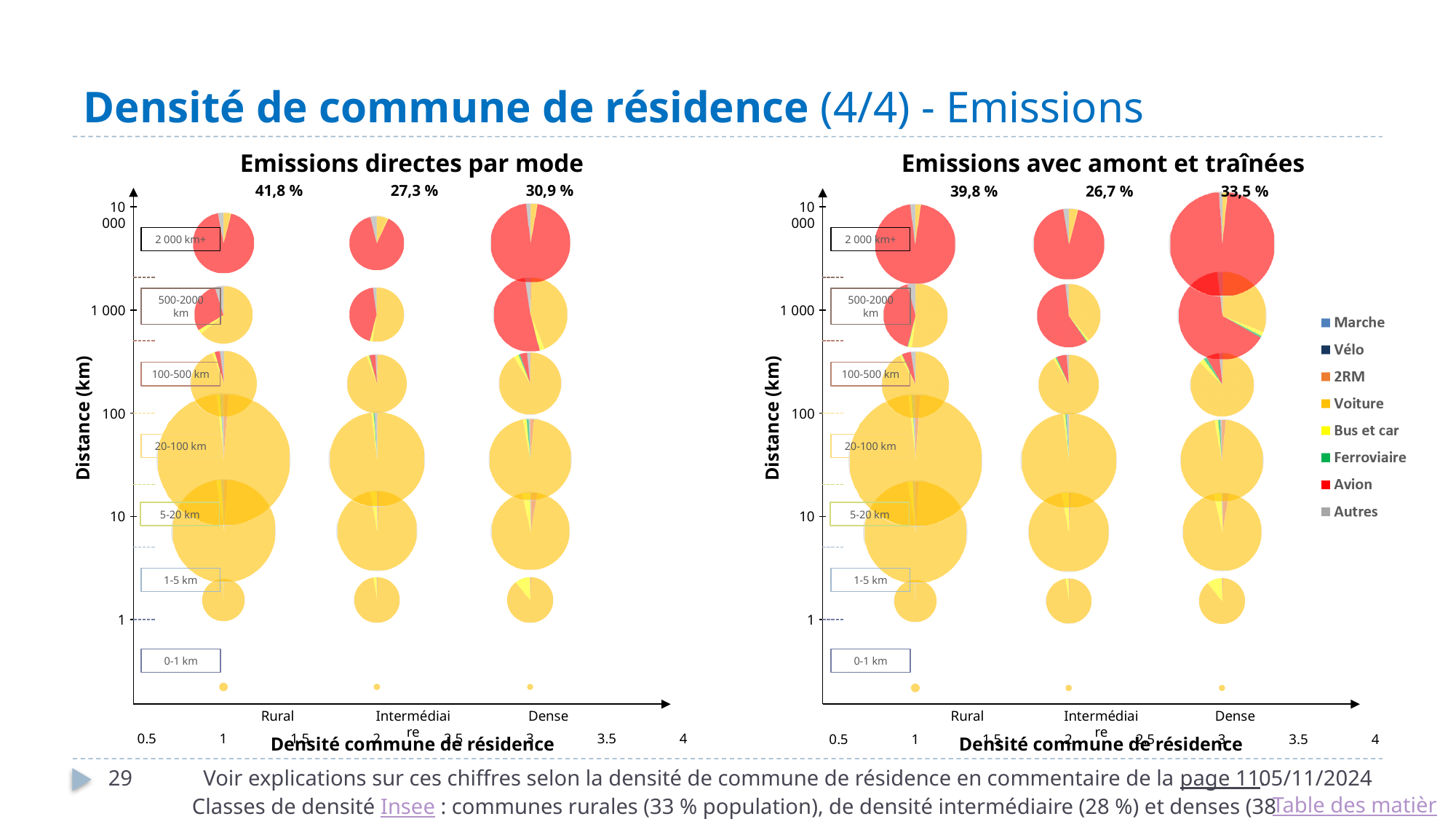
How many density categories are labelled along the x axis of each chart? 3 In the 'Emissions avec amont et traînées' chart, what percentage is printed above the Intermédiaire column? 26,7 % How many series does the legend on the right of the slide list? 8 In the 'Emissions directes par mode' chart, what is the difference between the Rural and Intermédiaire percentages? 14,5 % In the 'Emissions directes par mode' chart, which density category has the highest percentage printed above it? Rural Is the Dense percentage larger in the 'Emissions directes par mode' chart or in the 'Emissions avec amont et traînées' chart? Emissions avec amont et traînées In the 'Emissions avec amont et traînées' chart, what is the difference between the Dense and Intermédiaire percentages? 6,8 % In the 'Emissions directes par mode' chart, what percentage is printed above the Rural column? 41,8 % In the legend, which mode is shown in red? Avion In the 'Emissions avec amont et traînées' chart, which density category has the lowest percentage printed above it? Intermédiaire In the 'Emissions avec amont et traînées' chart, what percentage is printed above the Dense column? 33,5 % In the 'Emissions directes par mode' chart, what percentage is printed above the Dense column? 30,9 %